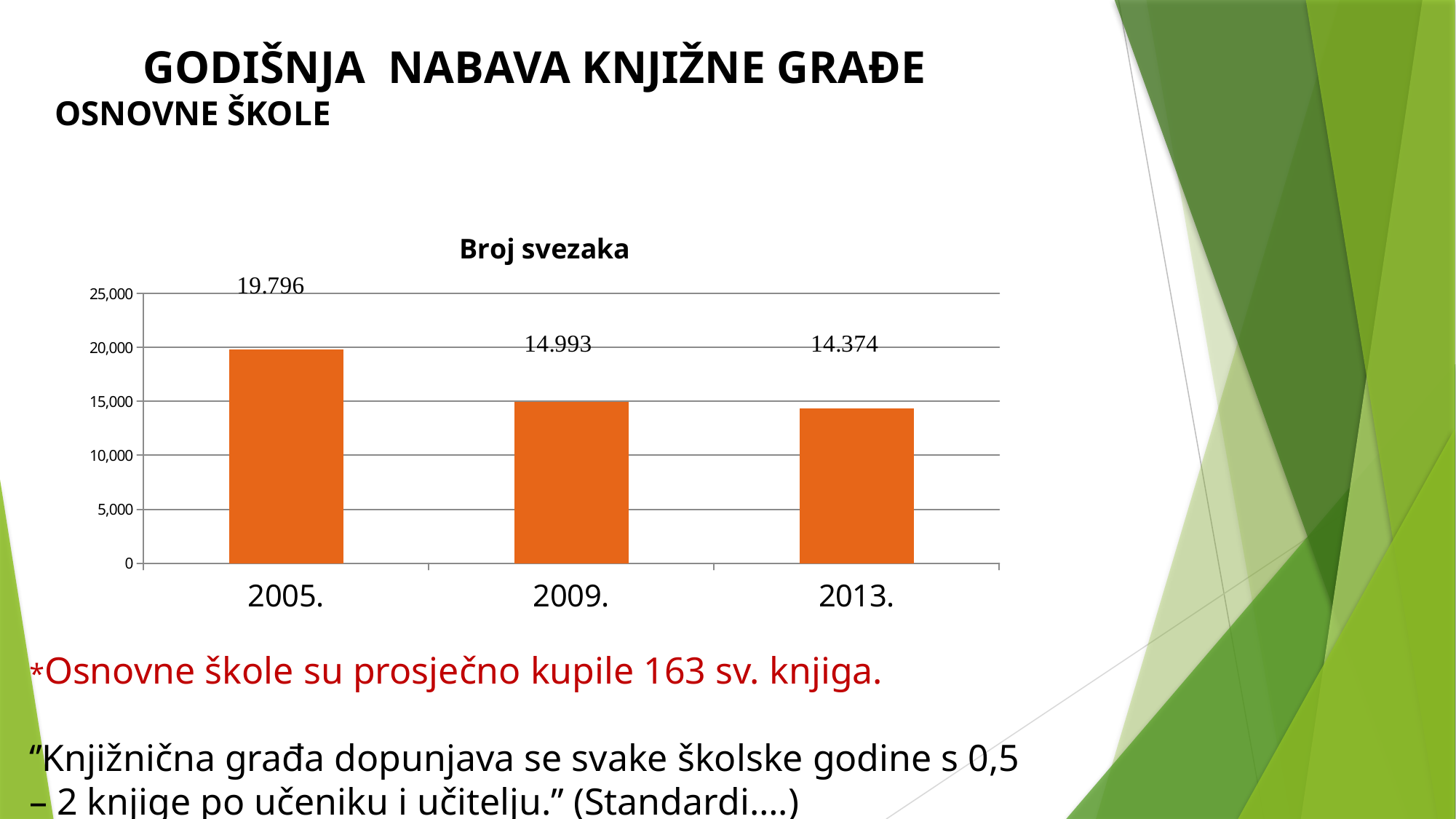
Which year has the lowest number of volumes in the Broj svezaka chart? 2013. What kind of chart is the Broj svezaka chart? bar chart What is the difference between the values for 2005. and 2009. in the Broj svezaka chart? 4.803 What is the value for 2005. in the Broj svezaka chart? 19.796 Which is larger in the Broj svezaka chart, the value for 2005. or the value for 2013.? 2005. Is the value for 2009. in the Broj svezaka chart greater or less than 20,000? less How many years are shown on the x axis of the Broj svezaka chart? 3 Which year has the highest number of volumes in the Broj svezaka chart? 2005. What is the value for 2013. in the Broj svezaka chart? 14.374 What is the difference between the values for 2009. and 2013. in the Broj svezaka chart? 619 Do the values in the Broj svezaka chart rise or fall from 2005. to 2013.? fall What is the value for 2009. in the Broj svezaka chart? 14.993